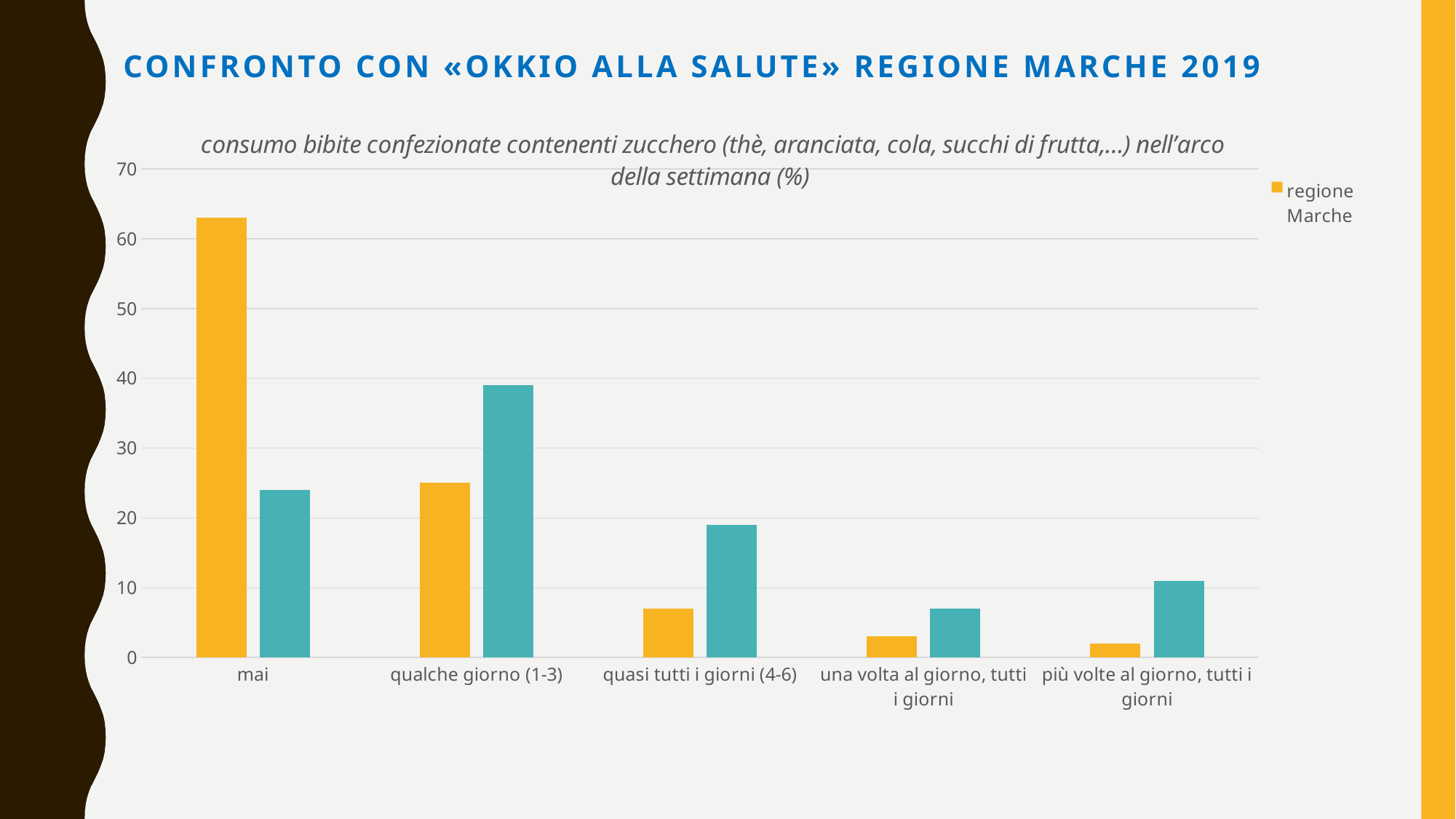
How many series does the chart's legend list? 1 Which category has the lowest value for the regione Marche series? più volte al giorno, tutti i giorni Is the teal bar for 'qualche giorno (1-3)' greater or less than 30? greater How many categories are shown on the x axis of the chart? 5 For the category 'mai', which bar is taller: the regione Marche bar or the teal bar? regione Marche What kind of chart is shown on the slide? bar chart For the category 'qualche giorno (1-3)', which bar is taller: the regione Marche bar or the teal bar? the teal bar Is the regione Marche value for 'mai' greater or less than 60? greater What colour are the bars for the regione Marche series? yellow Is the regione Marche value for 'quasi tutti i giorni (4-6)' greater or less than 10? less Do the regione Marche values rise or fall moving from left to right along the x axis? fall Which category has the highest value for the regione Marche series? mai